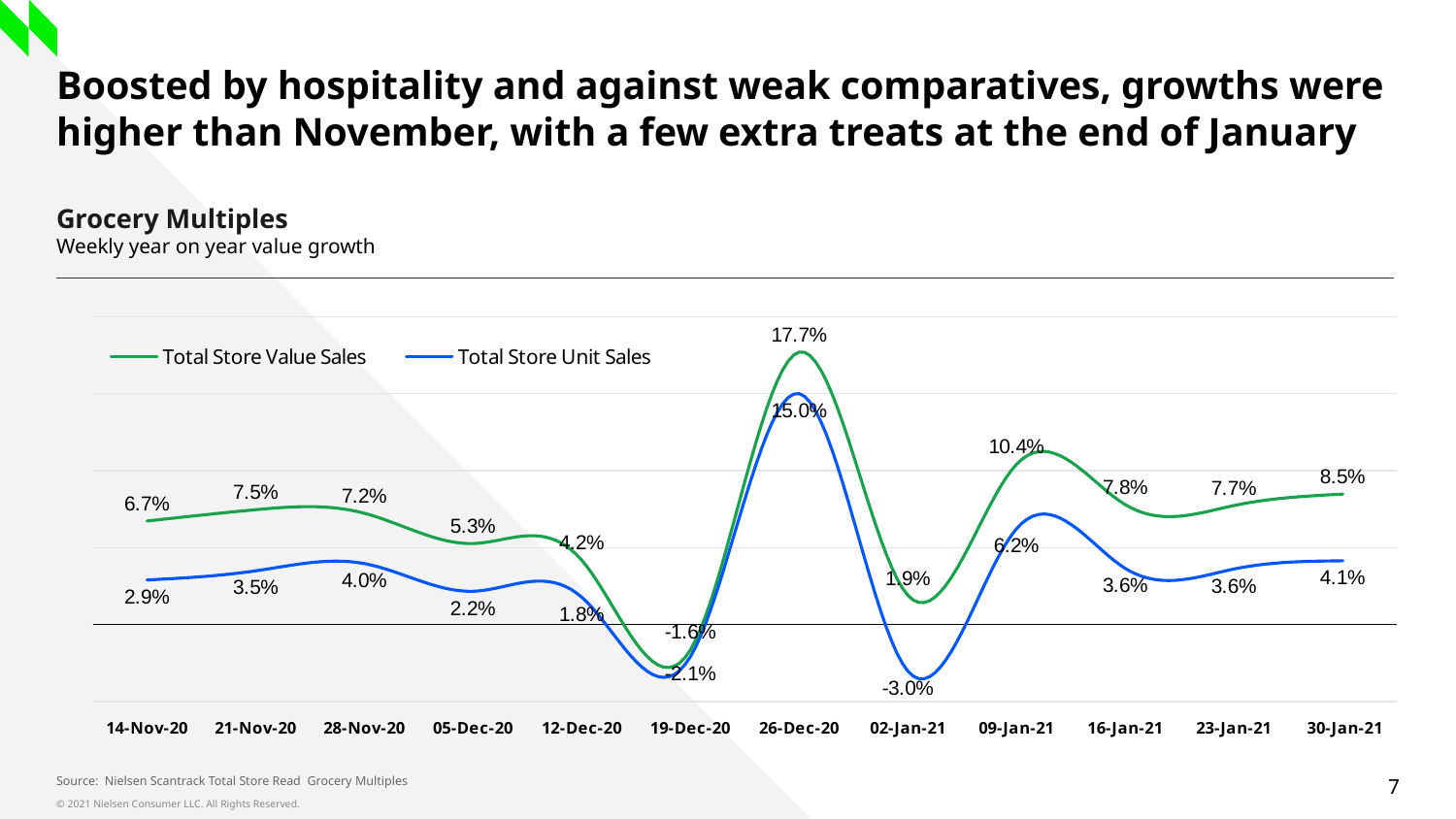
On which date is Total Store Value Sales growth highest? 26-Dec-20 What is the Total Store Value Sales growth for 30-Jan-21? 8.5% How many series does the legend list? 2 On which date is Total Store Unit Sales growth lowest? 02-Jan-21 On 09-Jan-21, which series has the higher growth: Total Store Value Sales or Total Store Unit Sales? Total Store Value Sales How many weekly dates are plotted along the x axis? 12 Does Total Store Unit Sales growth rise or fall from 14-Nov-20 to 28-Nov-20? Rise What is the difference between Total Store Value Sales and Total Store Unit Sales growth on 26-Dec-20? 2.7 percentage points What is the Total Store Unit Sales growth for 02-Jan-21? -3.0% What is the Total Store Value Sales growth for 26-Dec-20? 17.7% What is the Total Store Unit Sales growth for 14-Nov-20? 2.9% What kind of chart is shown on the slide? Line chart